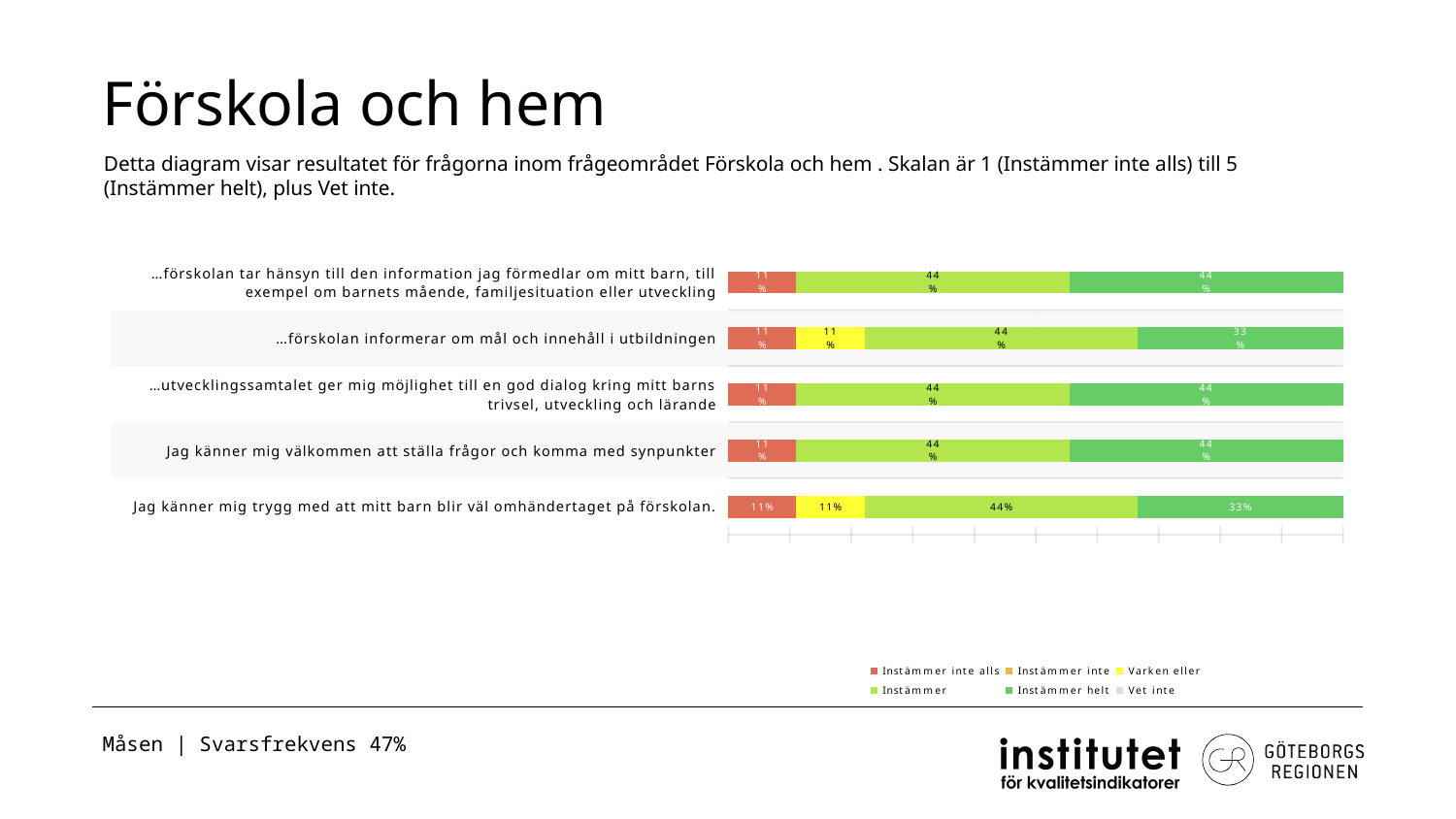
How many series does the legend list? 6 What is the 'Instämmer helt' value for '…utvecklingssamtalet ger mig möjlighet till en god dialog kring mitt barns trivsel, utveckling och lärande'? 44% Which is larger for 'Jag känner mig trygg med att mitt barn blir väl omhändertaget på förskolan.': the 'Instämmer' value or the 'Instämmer helt' value? Instämmer What is the difference between the 'Instämmer' value and the 'Instämmer helt' value for '…förskolan informerar om mål och innehåll i utbildningen'? 11% What is the total of the labelled segments for '…förskolan tar hänsyn till den information jag förmedlar om mitt barn, till exempel om barnets mående, familjesituation eller utveckling'? 99% What is the title of the slide containing the chart? Förskola och hem What kind of chart is shown on the slide? Stacked bar chart What is the 'Instämmer' value for '…förskolan informerar om mål och innehåll i utbildningen'? 44% What is the 'Varken eller' value for 'Jag känner mig trygg med att mitt barn blir väl omhändertaget på förskolan.'? 11% What is the 'Instämmer helt' value for 'Jag känner mig trygg med att mitt barn blir väl omhändertaget på förskolan.'? 33% What is the 'Instämmer inte alls' value for 'Jag känner mig välkommen att ställa frågor och komma med synpunkter'? 11% How many questions (categories) are plotted in the chart? 5